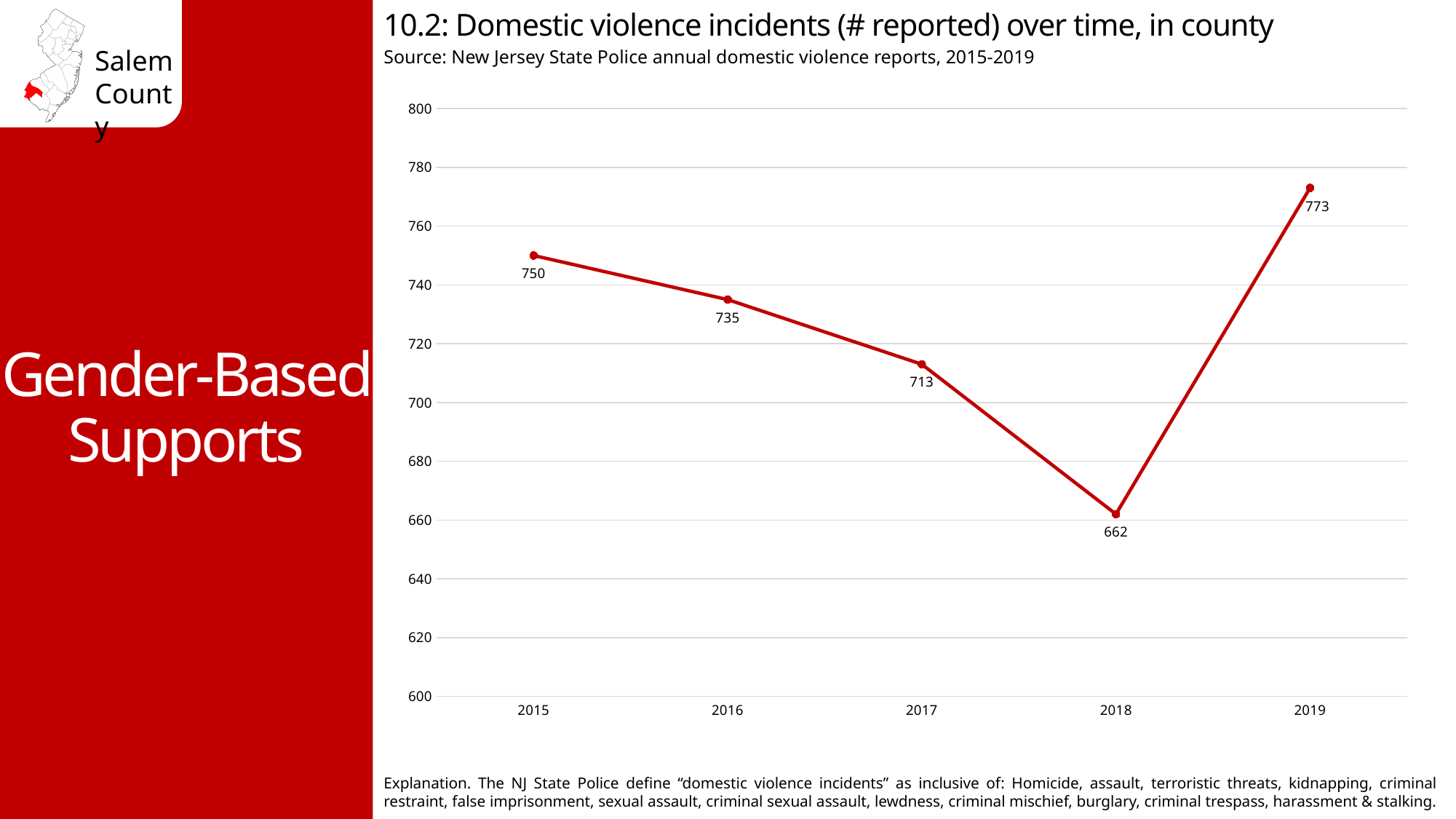
Which year has the lowest number of reported incidents? 2018 Is the value for 2017 greater or less than 700? greater What is the difference between the 2015 and 2016 values? 15 What is the difference between the 2019 and 2018 values? 111 Which year has the highest number of reported incidents? 2019 How many incidents were reported in 2019? 773 Do the values rise or fall from 2015 to 2018? Fall What kind of chart is shown on the slide? Line chart How many domestic violence incidents were reported in 2015? 750 How many years are plotted on the chart? 5 Which year had more reported incidents, 2016 or 2017? 2016 What is the value plotted for 2018? 662